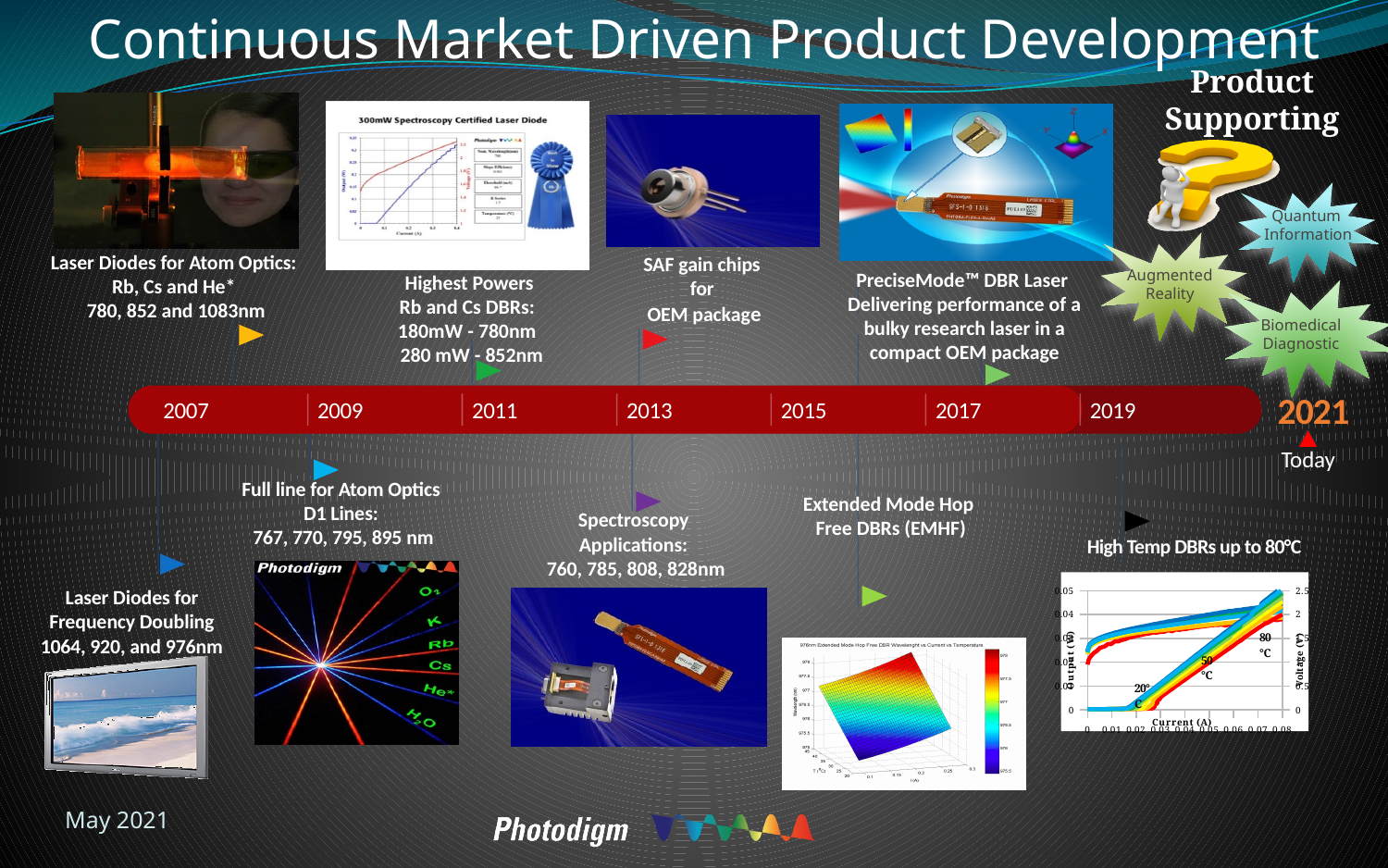
What kind of chart is the 'High Temp DBRs up to 80°C' chart at the bottom right of the slide? line chart What is the title of the chart at the bottom right of the slide, above the 2019 timeline marker? High Temp DBRs up to 80°C In the 'High Temp DBRs up to 80°C' chart, which curve has the higher output at 0.08 A, 20°C or 80°C? 20°C In the 'High Temp DBRs up to 80°C' chart, which temperature curve has the lowest output at 0.08 A? 80°C In the 'High Temp DBRs up to 80°C' chart, what is the highest temperature labelled on a curve? 80°C In the 'High Temp DBRs up to 80°C' chart, which temperature curve reaches the highest output at 0.08 A? 20°C What is the x-axis label of the 'High Temp DBRs up to 80°C' chart? Current (A) In the 'High Temp DBRs up to 80°C' chart, does the output rise or fall as current increases? rises In the 'High Temp DBRs up to 80°C' chart, how many temperature curves are labelled? 3